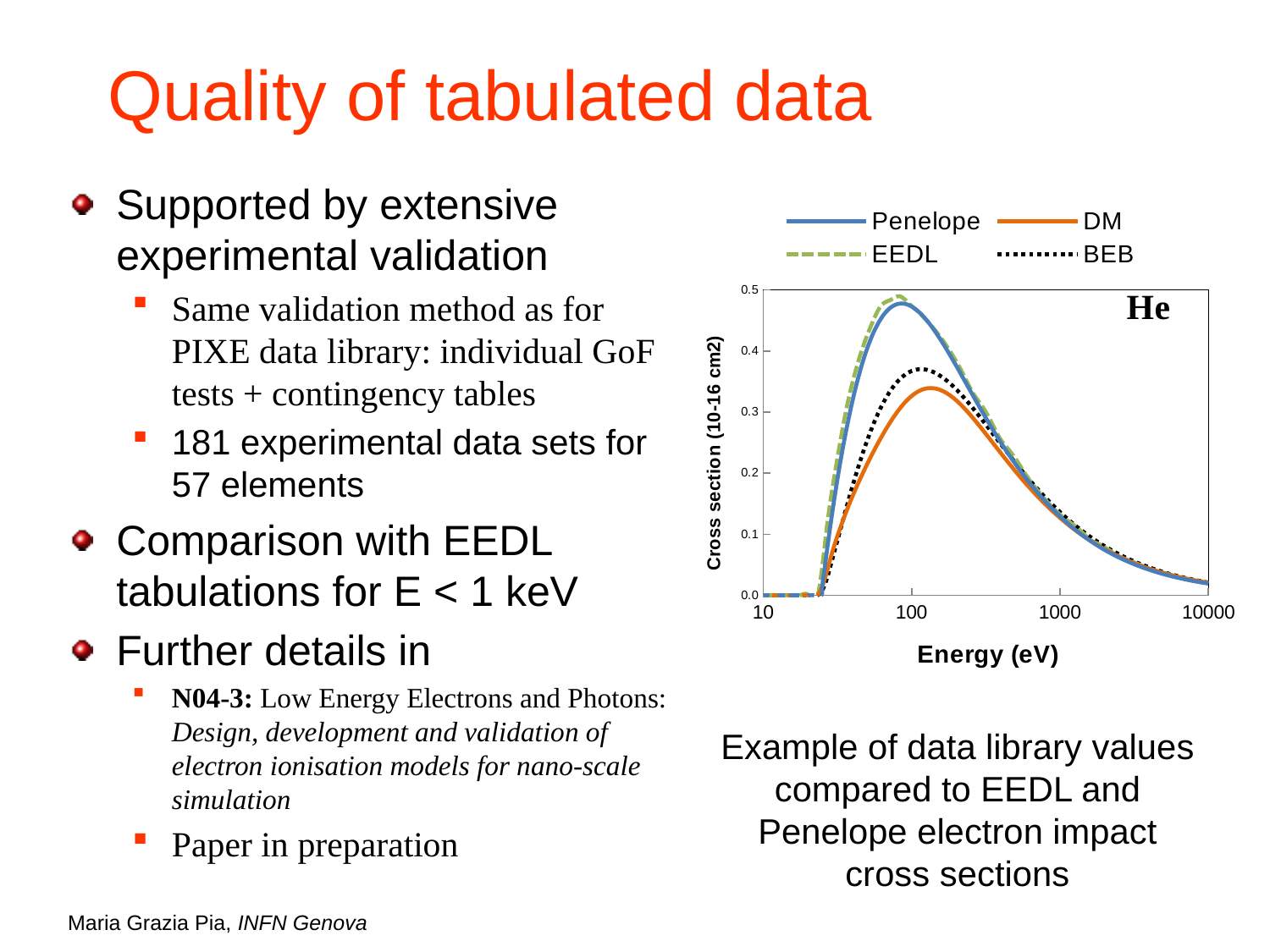
Which series are listed in the chart legend? Penelope, DM, EEDL, BEB Is the peak value of the BEB curve greater or less than 0.4? less What is the label of the x axis of the chart? Energy (eV) What kind of chart is shown on the slide? line chart Do the cross section values rise or fall as energy increases from 1000 eV to 10000 eV? fall Is the peak value of the Penelope curve greater or less than 0.4? greater How many series does the chart legend list? 4 Which series has the lowest peak cross section? DM Which curve reaches a higher peak, Penelope or DM? Penelope Are the cross section values at 10000 eV greater or less than 0.1? less